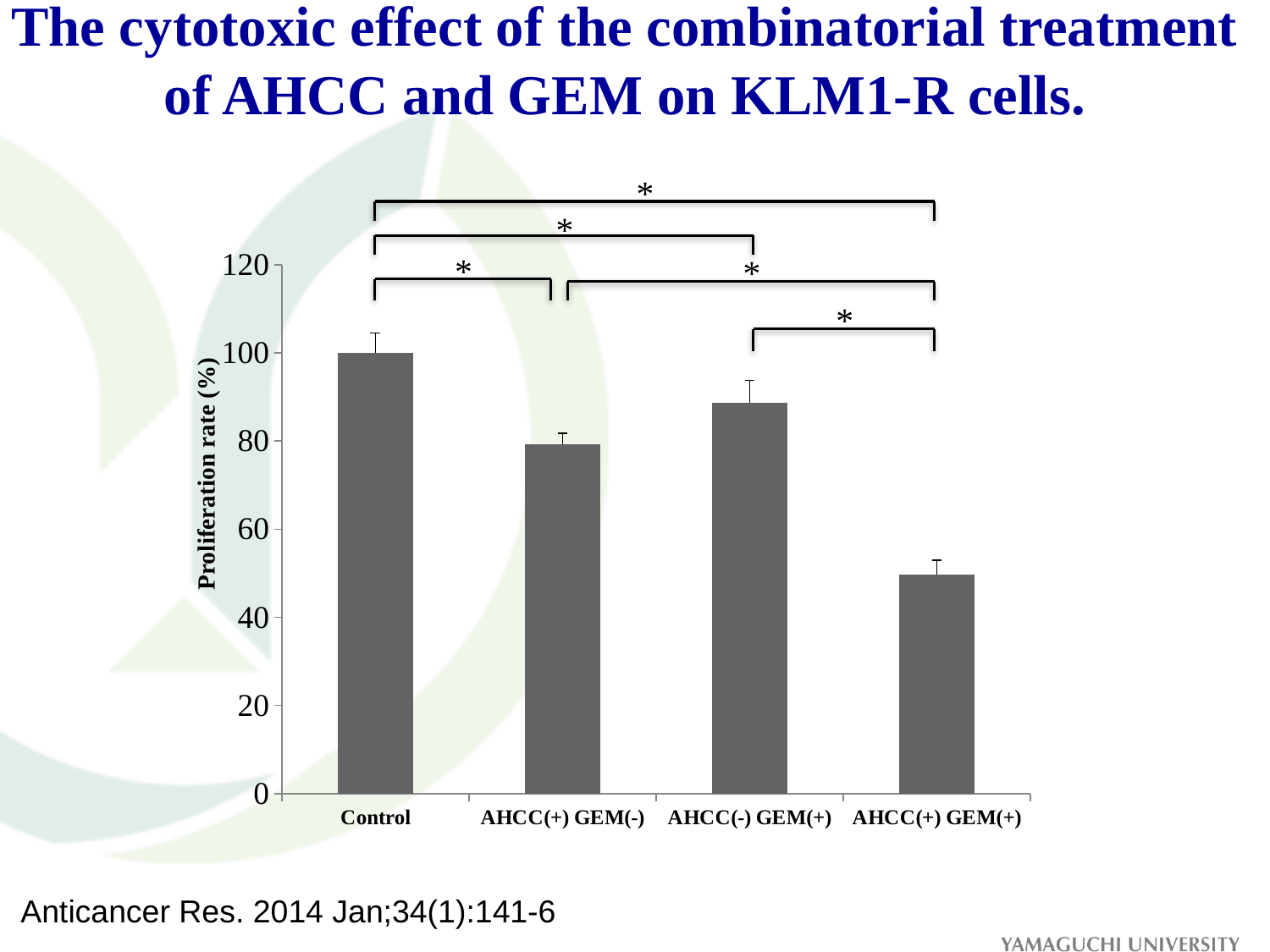
What is the label of the y-axis? Proliferation rate (%) What is the proliferation rate (%) of the Control group? 100 Which treatment group has the lowest proliferation rate? AHCC(+) GEM(+) Which has a higher proliferation rate, AHCC(+) GEM(-) or AHCC(-) GEM(+)? AHCC(-) GEM(+) What is the title of the slide containing the chart? The cytotoxic effect of the combinatorial treatment of AHCC and GEM on KLM1-R cells. Is the proliferation rate for AHCC(+) GEM(+) greater or less than 60? less How many treatment groups (bars) are plotted in the chart? 4 What kind of chart is shown on the slide? bar chart Which treatment group has the highest proliferation rate? Control Is the proliferation rate for AHCC(+) GEM(+) greater or less than 40? greater Is the proliferation rate for AHCC(-) GEM(+) greater or less than 100? less